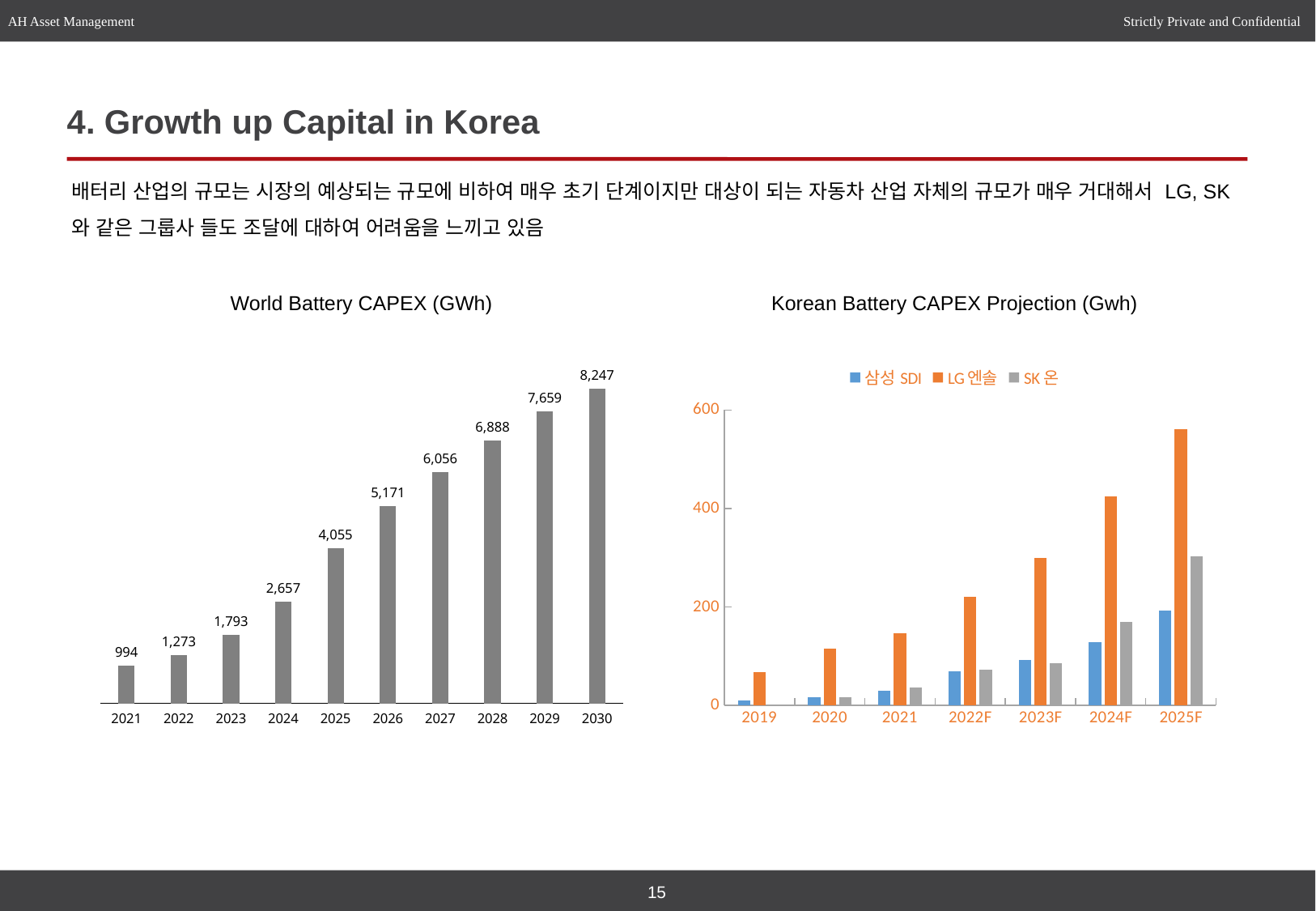
In the World Battery CAPEX (GWh) chart, how many years are shown on the x axis? 10 In the World Battery CAPEX (GWh) chart, what is the difference between the 2030 and 2029 values? 588 In the World Battery CAPEX (GWh) chart, what is the value for 2025? 4,055 In the Korean Battery CAPEX Projection (Gwh) chart, which series has the highest value in 2024F? LG 엔솔 In the World Battery CAPEX (GWh) chart, do the values rise or fall from 2021 to 2030? rise In the Korean Battery CAPEX Projection (Gwh) chart, how many series does the legend list? 3 What kind of chart is the World Battery CAPEX (GWh) chart? bar chart In the World Battery CAPEX (GWh) chart, which year has the lowest value? 2021 In the Korean Battery CAPEX Projection (Gwh) chart, is the value for LG 엔솔 in 2025F greater or less than 400? greater In the World Battery CAPEX (GWh) chart, what is the value for 2030? 8,247 In the Korean Battery CAPEX Projection (Gwh) chart, which series is shown in orange? LG 엔솔